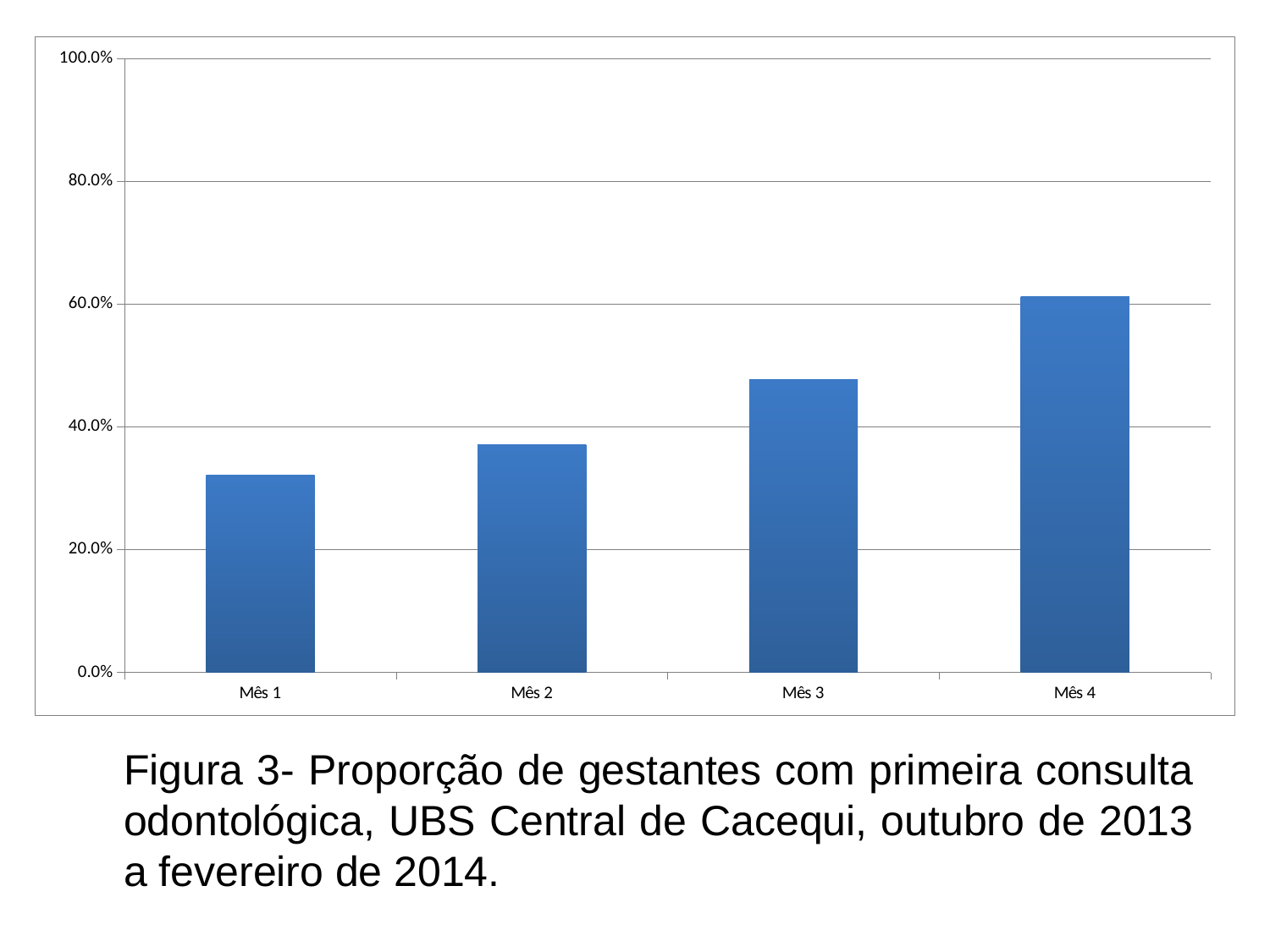
What kind of chart is shown on the slide? bar chart Is the value for Mês 3 greater or less than 60.0%? less Is the value for Mês 3 greater or less than 40.0%? greater Which month has the lowest proportion? Mês 1 Which month has the highest proportion? Mês 4 According to the caption, which health unit (UBS) does the chart refer to? UBS Central de Cacequi Is the value for Mês 1 greater or less than 40.0%? less Which is larger, the value for Mês 2 or the value for Mês 3? Mês 3 How many months (categories) are plotted on the x axis? 4 Do the values rise or fall from Mês 1 to Mês 4? rise